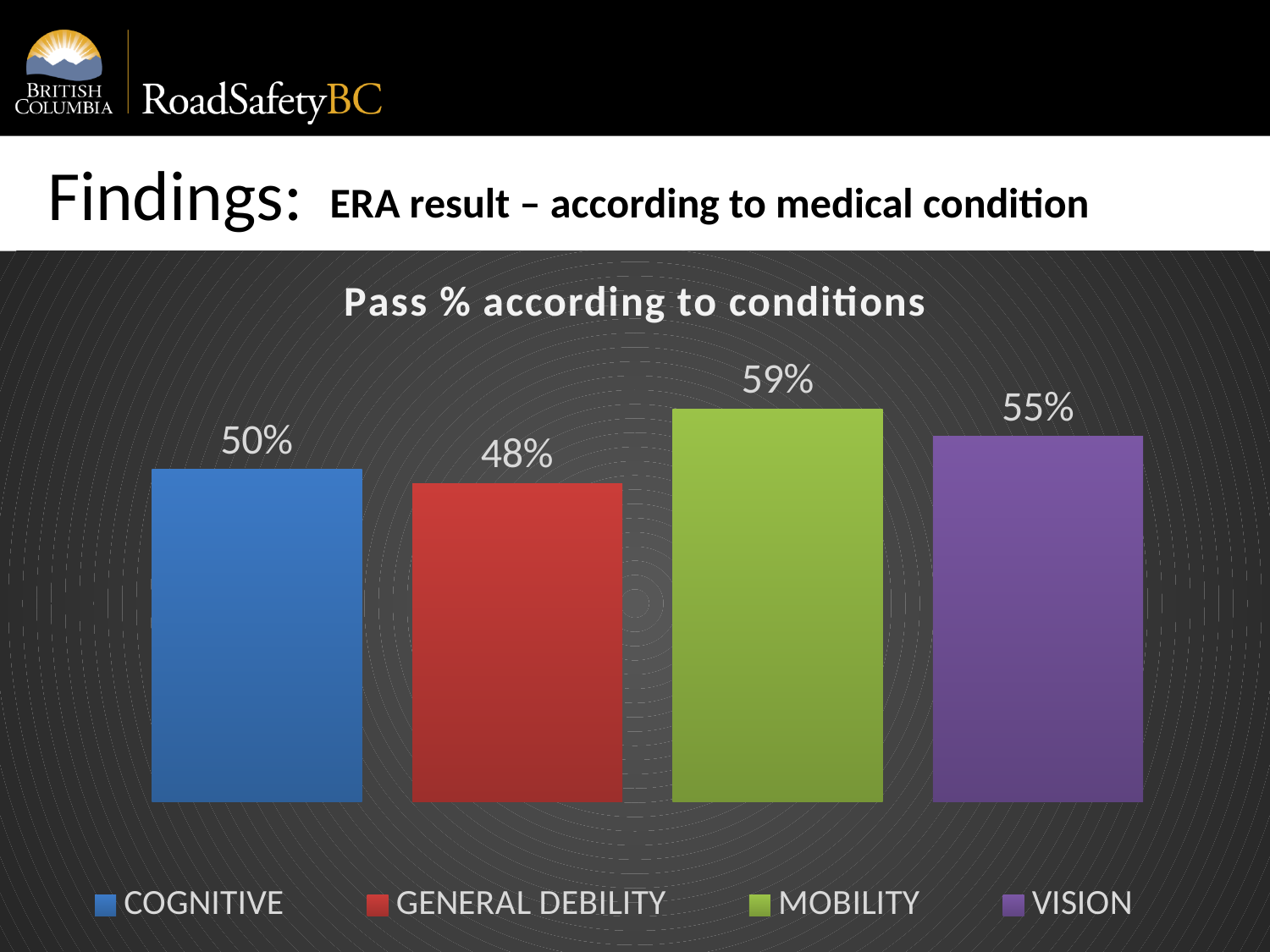
What is the pass % for GENERAL DEBILITY? 48% What is the title of the chart? Pass % according to conditions What is the difference in pass % between MOBILITY and GENERAL DEBILITY? 11% What is the difference in pass % between VISION and COGNITIVE? 5% What is the pass % for COGNITIVE? 50% What is the pass % for VISION? 55% How many conditions are shown in the chart? 4 Which condition has the highest pass %? MOBILITY What is the pass % for MOBILITY? 59% Which condition has the lowest pass %? GENERAL DEBILITY What kind of chart is shown on the slide? Bar chart Which has a higher pass %, VISION or COGNITIVE? VISION